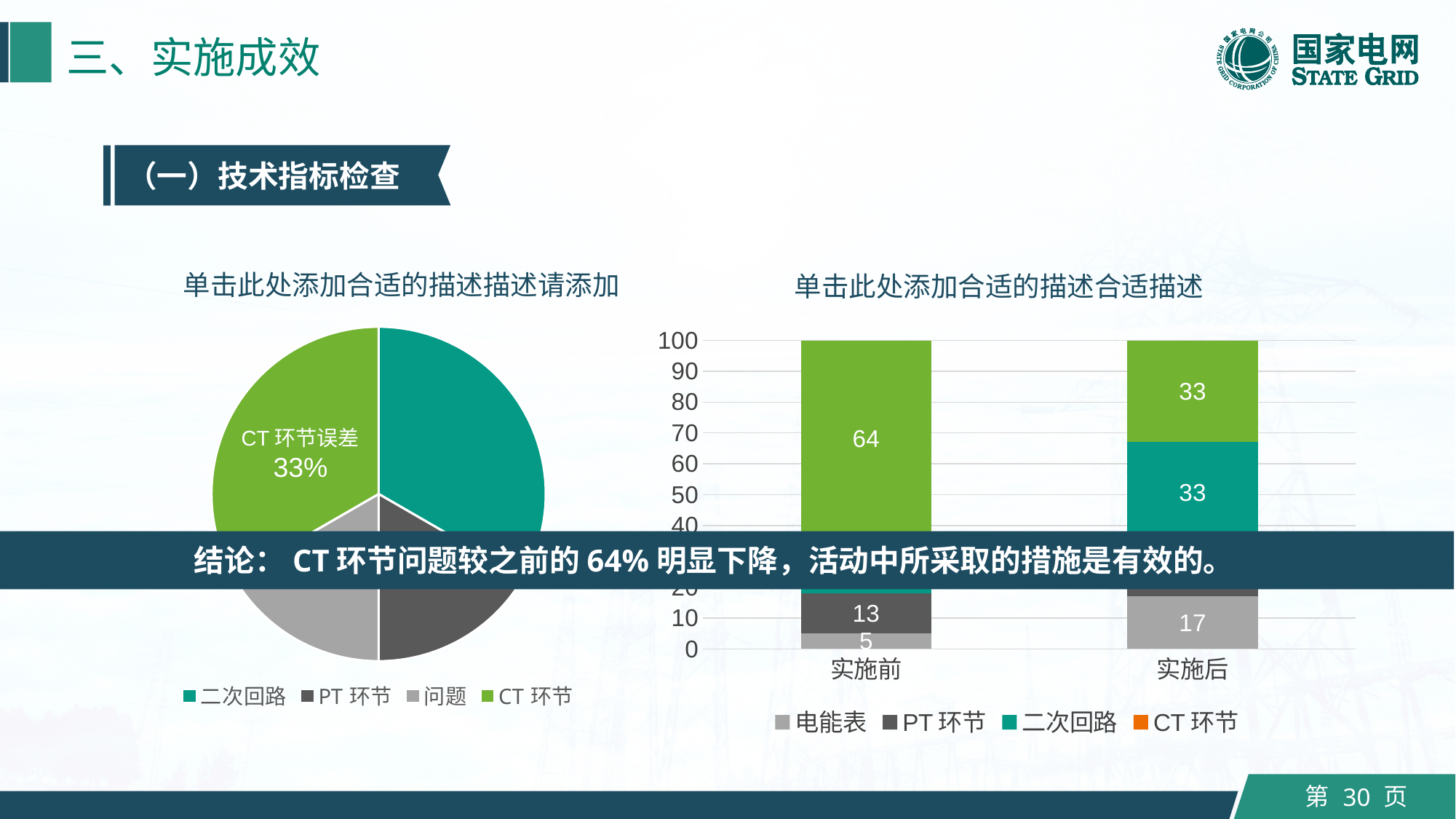
How many series does the legend of the bar chart on the right list? 4 In the bar chart on the right, what is the value of the top green segment of the 实施前 bar? 64 How many categories are shown on the x axis of the bar chart on the right? 2 What kind of chart is the chart on the right of the slide? bar chart In the pie chart on the left, what share is labelled for CT 环节误差? 33% How many entries does the legend of the pie chart on the left list? 4 In the bar chart on the right, what is the value of the dark gray segment of the 实施前 bar? 13 In the bar chart on the right, what total does each stacked bar reach on the y axis? 100 What kind of chart is the chart on the left of the slide? pie chart In the bar chart on the right, what is the value of the bottom segment of the 实施前 bar? 5 In the bar chart on the right, what is the difference between the top green segment of 实施前 and the top green segment of 实施后? 31 In the bar chart on the right, what is the value of the bottom light gray segment of the 实施后 bar? 17